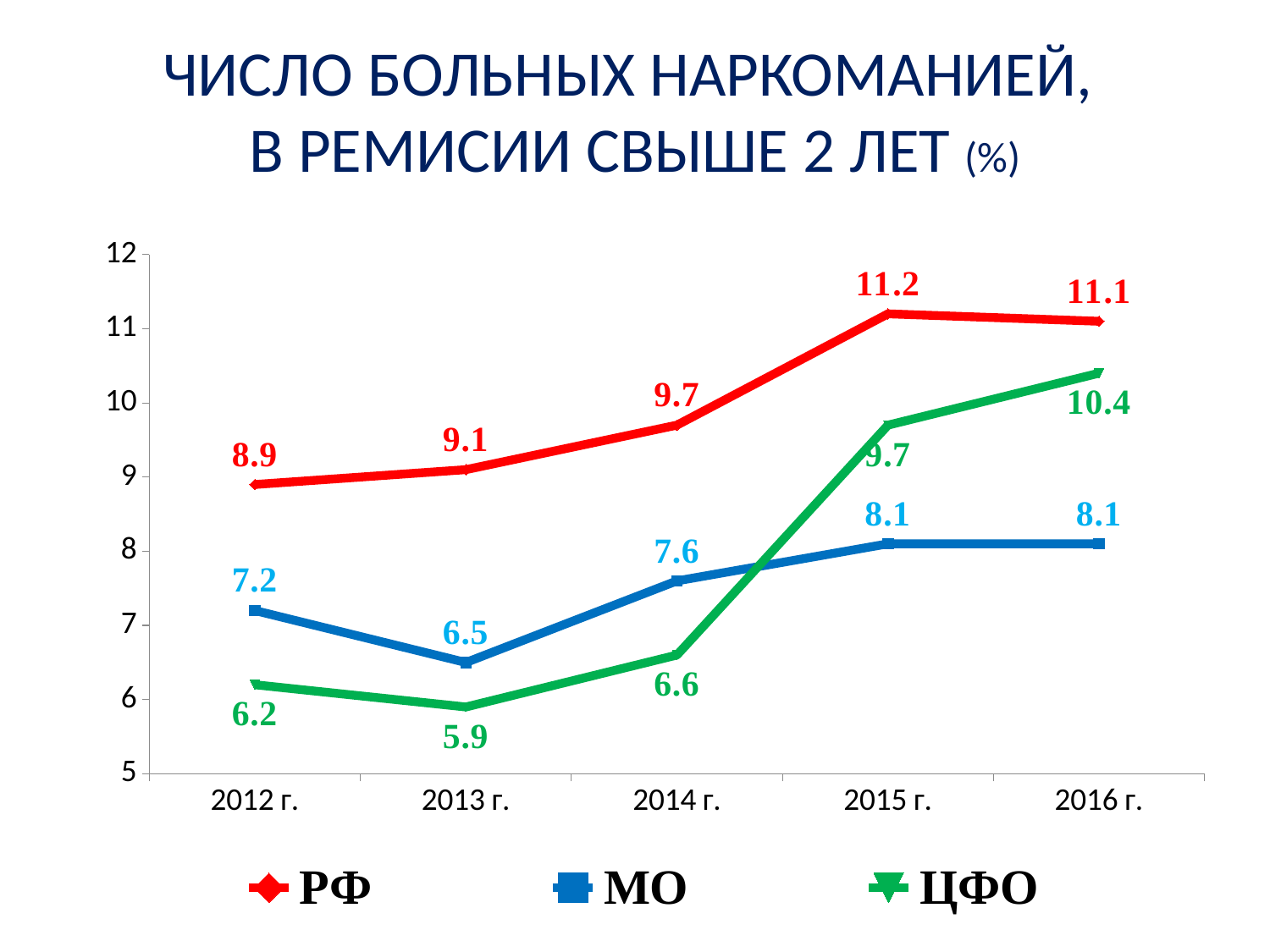
In which year is the РФ series highest? 2015 г. What is the value for ЦФО in 2016 г.? 10.4 What kind of chart is shown on the slide? line chart Which is larger in 2014 г., the value for МО or the value for ЦФО? МО In which year is the ЦФО series lowest? 2013 г. What is the value for МО in 2013 г.? 6.5 Is the value for ЦФО in 2015 г. greater or less than 9? greater Does the ЦФО series rise or fall from 2013 г. to 2016 г.? rise How many series does the legend list? 3 How many years are shown on the x axis? 5 What is the difference between the РФ and МО values in 2012 г.? 1.7 What is the value for РФ in 2015 г.? 11.2